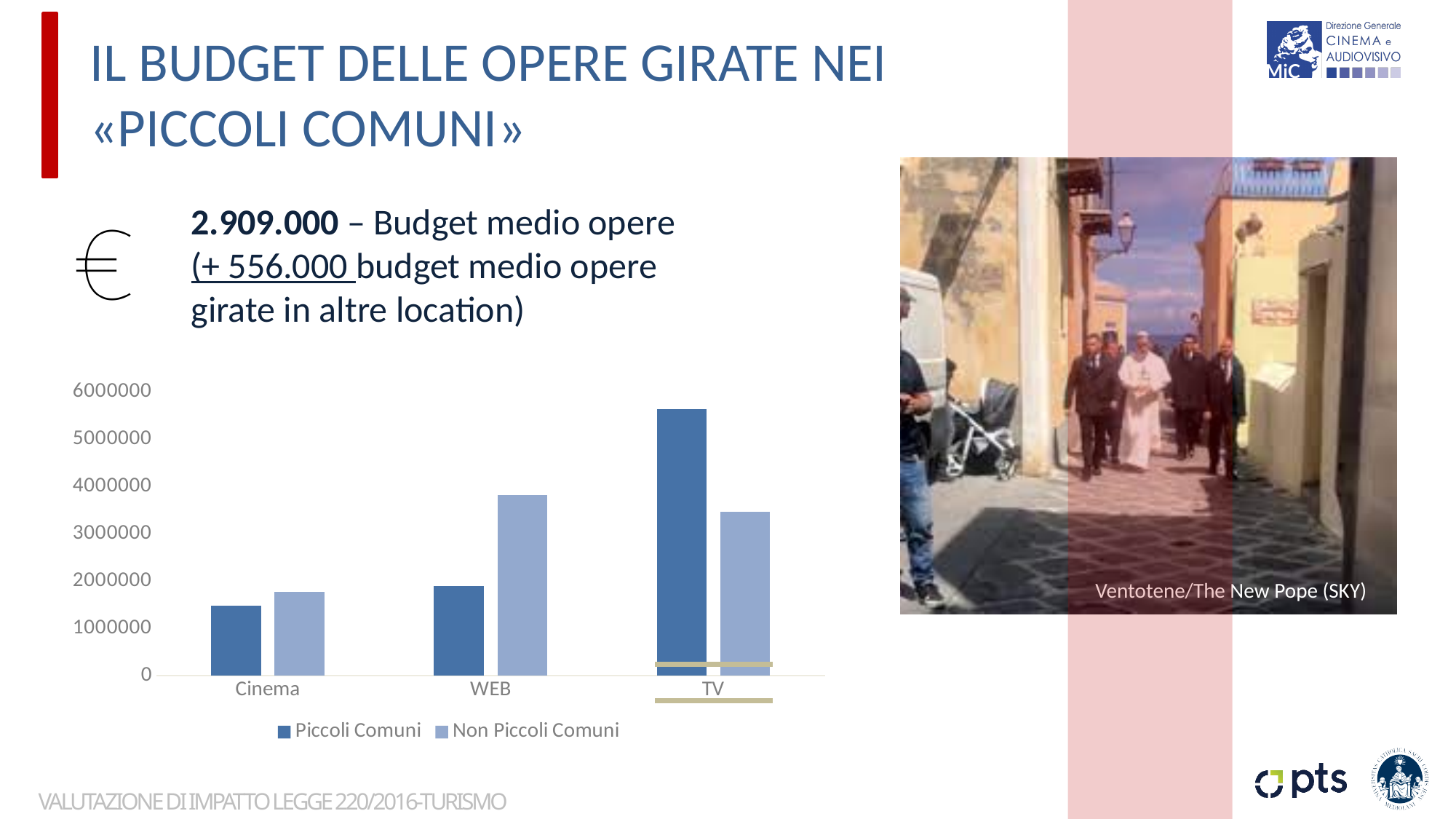
Which category has the lowest value for the Piccoli Comuni series? Cinema Which category has the highest value for the Piccoli Comuni series? TV Which category has the highest value for the Non Piccoli Comuni series? WEB How many categories are shown on the x axis of the chart? 3 For TV, which series has the larger value, Piccoli Comuni or Non Piccoli Comuni? Piccoli Comuni Is the Non Piccoli Comuni value for WEB greater or less than 3000000? greater Is the Piccoli Comuni value for TV greater or less than 5000000? greater How many series does the chart legend list? 2 Is the Piccoli Comuni value for Cinema greater or less than 2000000? less For WEB, which series has the larger value, Piccoli Comuni or Non Piccoli Comuni? Non Piccoli Comuni Do the Piccoli Comuni values rise or fall from Cinema to TV along the x axis? rise What kind of chart is shown on the slide? bar chart